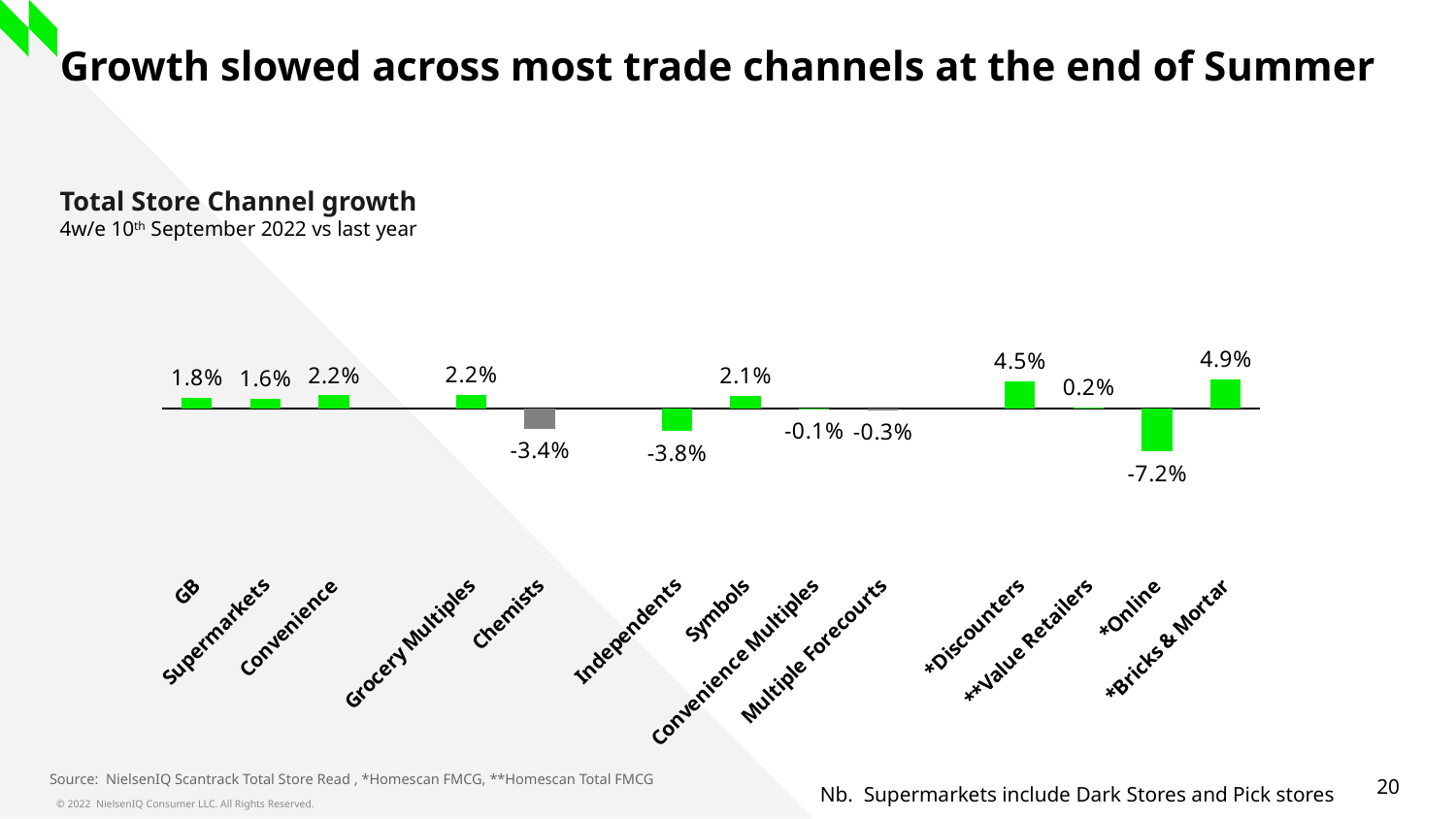
What is the growth value shown for Supermarkets? 1.6% Which has the larger growth value, Independents or Chemists? Chemists Which channel has the highest growth value on the chart? *Bricks & Mortar Which has the larger growth value, GB or Symbols? Symbols Which channel has the lowest growth value on the chart? *Online What is the difference in percentage points between the values for *Bricks & Mortar and *Discounters? 0.4 percentage points How many channels are plotted on the chart? 13 What is the growth value shown for *Online? -7.2% What period does the chart subtitle say the data covers? 4w/e 10th September 2022 vs last year What is the growth value shown for *Discounters? 4.5% What kind of chart is shown on the slide? Bar chart What is the growth value shown for Chemists? -3.4%